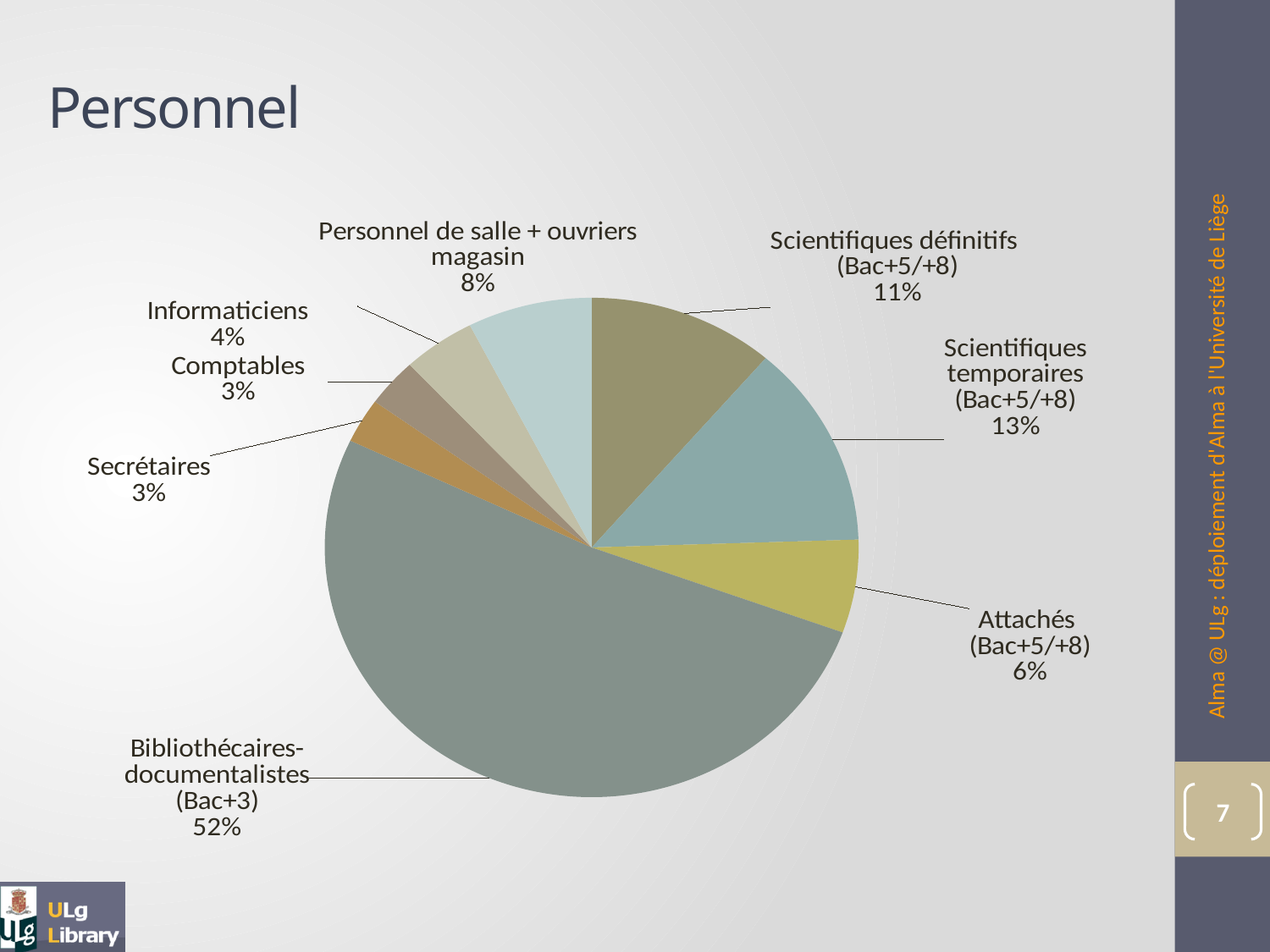
What is the difference in percentage points between Bibliothécaires-documentalistes (Bac+3) and Scientifiques temporaires (Bac+5/+8)? 39 Which is larger, Scientifiques temporaires (Bac+5/+8) or Scientifiques définitifs (Bac+5/+8)? Scientifiques temporaires (Bac+5/+8) How many slices does the pie chart have? 8 What percentage is shown for Informaticiens? 4% What share of the pie is Bibliothécaires-documentalistes (Bac+3)? 52% Which category has the largest slice of the pie? Bibliothécaires-documentalistes (Bac+3) What percentage is shown for Personnel de salle + ouvriers magasin? 8% What percentage is shown for Scientifiques temporaires (Bac+5/+8)? 13% What percentage is shown for Scientifiques définitifs (Bac+5/+8)? 11% What kind of chart is shown on the slide? pie chart What is the title of the slide containing the pie chart? Personnel What percentage is shown for Attachés (Bac+5/+8)? 6%